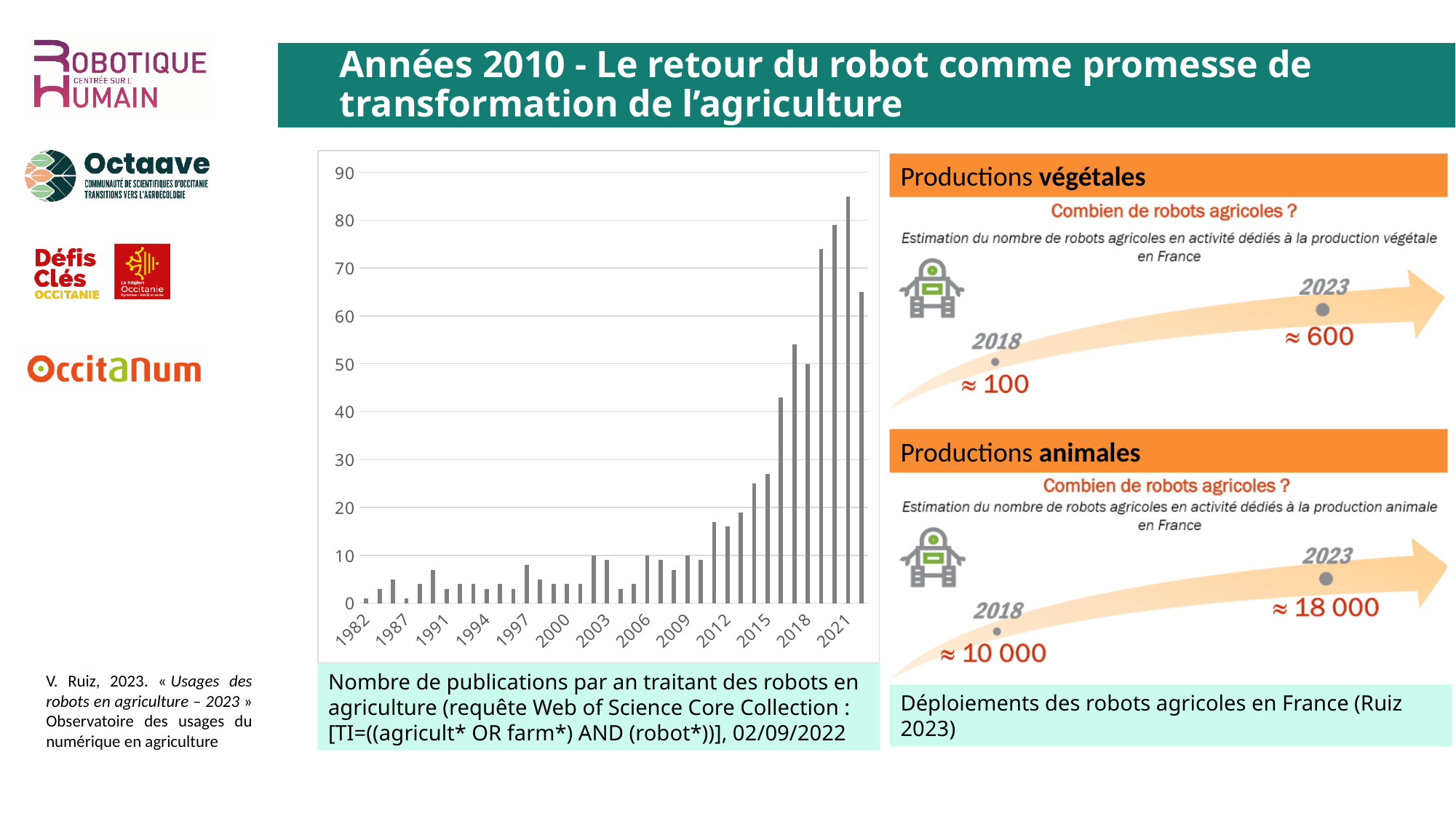
What is the highest value shown on the y axis of the bar chart? 90 How many year labels are shown on the x axis of the bar chart? 13 In the bar chart of publications per year, is the value for 2015 greater or less than 40? less What kind of chart is shown on the left of the slide? bar chart In the bar chart of publications per year, is the value for 2012 greater or less than 10? greater In the bar chart of publications per year, is the tallest bar greater or less than 80? greater In the bar chart of publications per year, which has the larger value, 2018 or 2009? 2018 Overall, do the values in the bar chart rise or fall from 1982 to 2021? rise In the bar chart of publications per year, which has the larger value, 2021 or 1997? 2021